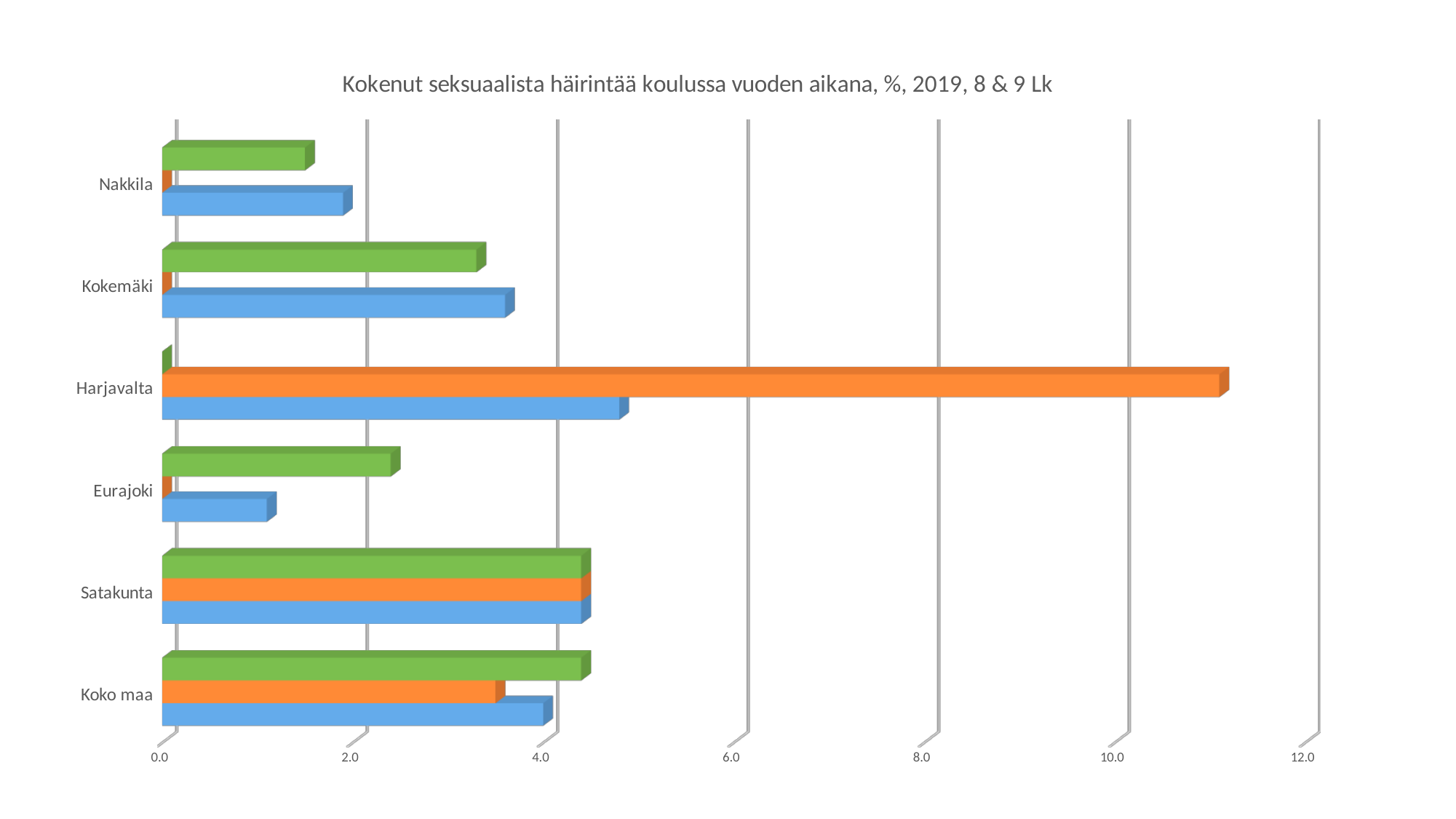
How many bars are plotted for each category? 3 For Nakkila, which is larger: the blue bar or the green bar? the blue bar Is the value of the green bar for Satakunta greater or less than 4.0? greater For Eurajoki, which is larger: the green bar or the blue bar? the green bar What is the title of the chart? Kokenut seksuaalista häirintää koulussa vuoden aikana, %, 2019, 8 & 9 Lk How many categories are shown on the vertical axis of the chart? 6 Is the value of the blue bar for Eurajoki greater or less than 2.0? less Which category has the shortest green bar? Harjavalta Which category has the longest orange bar? Harjavalta Which category has the shortest blue bar? Eurajoki What kind of chart is shown on the slide? bar chart Is the value of the orange bar for Harjavalta greater or less than 10.0? greater